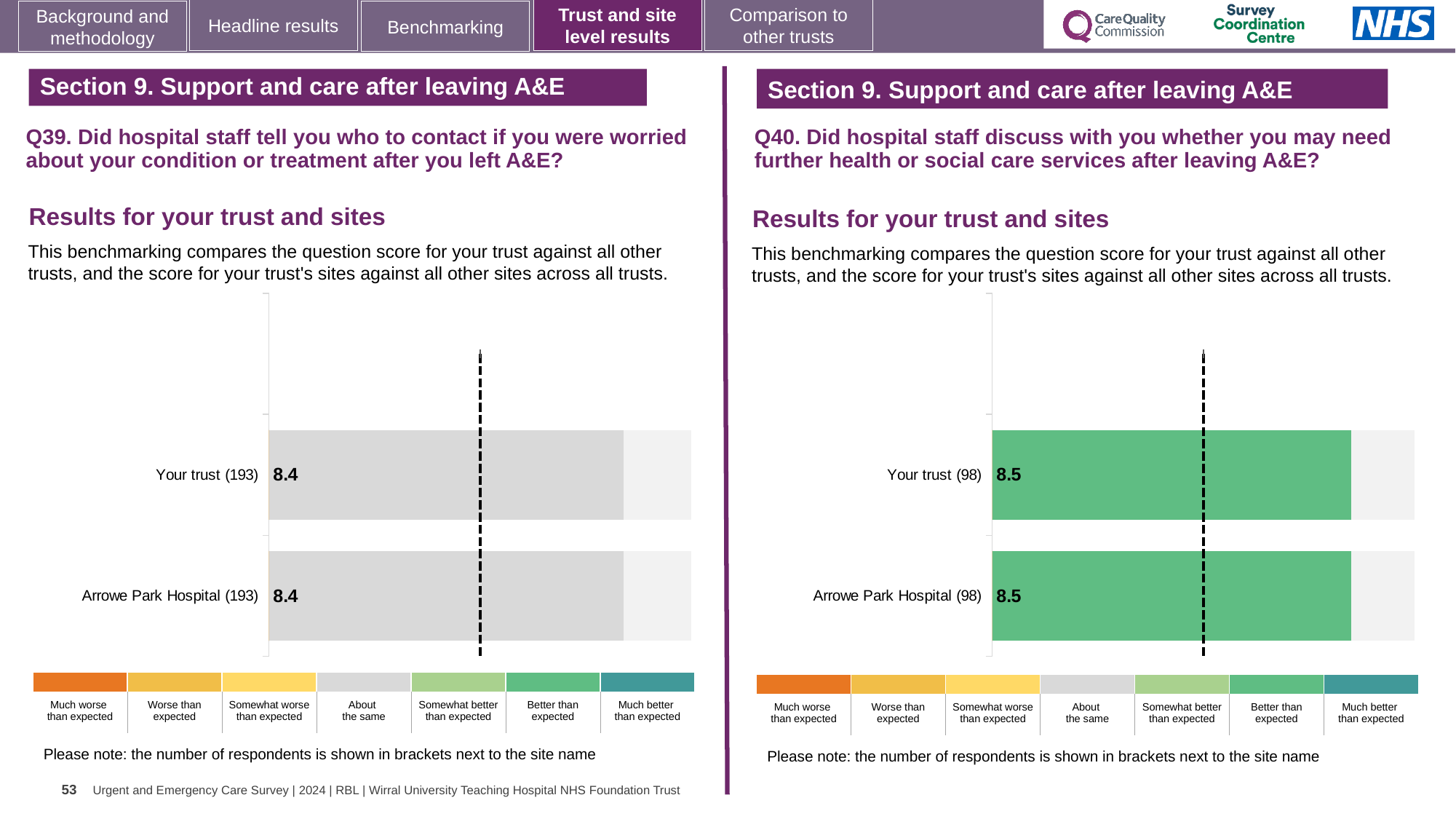
What kind of chart is shown on the left for Q39? Bar chart In the Q39 chart on the left, what is the difference between the Your trust score and the Arrowe Park Hospital score? 0 In the Q39 chart on the left, what is the score for Arrowe Park Hospital? 8.4 In the Q39 chart on the left, how many respondents are shown in brackets for Arrowe Park Hospital? 193 In the Q39 chart on the left, which benchmark category does the colour of the bars correspond to in the key? About the same In the Q40 chart on the right, how many respondents are shown in brackets for Your trust? 98 In the Q39 chart on the left, what is the score for Your trust? 8.4 In the Q40 chart on the right, which benchmark category does the colour of the bars correspond to in the key? Better than expected In the Q40 chart on the right, what is the score for Arrowe Park Hospital? 8.5 In the Q40 chart on the right, how many bars are plotted? 2 Is the Your trust score in the Q40 chart on the right larger than the Your trust score in the Q39 chart on the left? Yes In the Q40 chart on the right, what is the score for Your trust? 8.5